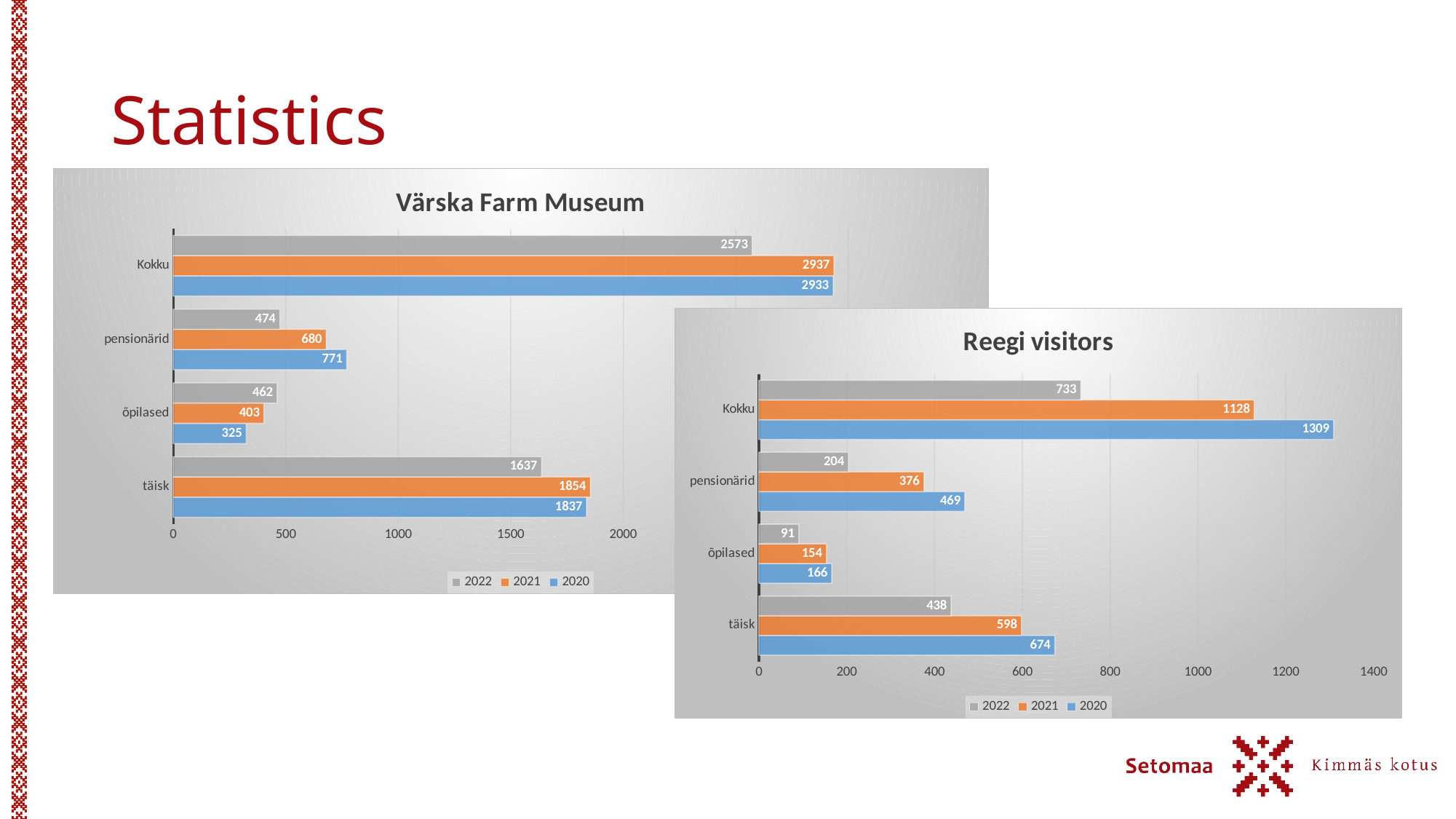
How many series does the legend of the Värska Farm Museum chart list? 3 In the Värska Farm Museum chart, what is the difference between the 2020 and 2021 values for pensionärid? 91 In the Värska Farm Museum chart, which colour represents 2020? blue In the Reegi visitors chart, is the 2021 value for täisk larger or smaller than the 2020 value for täisk? smaller In the Reegi visitors chart, what is the difference between the 2020 and 2022 values for Kokku? 576 In the Reegi visitors chart, what is the value for pensionärid in 2020? 469 In the Värska Farm Museum chart, what is the value for Kokku in 2021? 2937 In the Värska Farm Museum chart, which year has the highest value for täisk? 2021 In the Reegi visitors chart, which category has the lowest value in 2022? õpilased How many categories are shown in the Reegi visitors chart? 4 What kind of chart is the Reegi visitors chart? bar chart In the Värska Farm Museum chart, what is the value for õpilased in 2022? 462